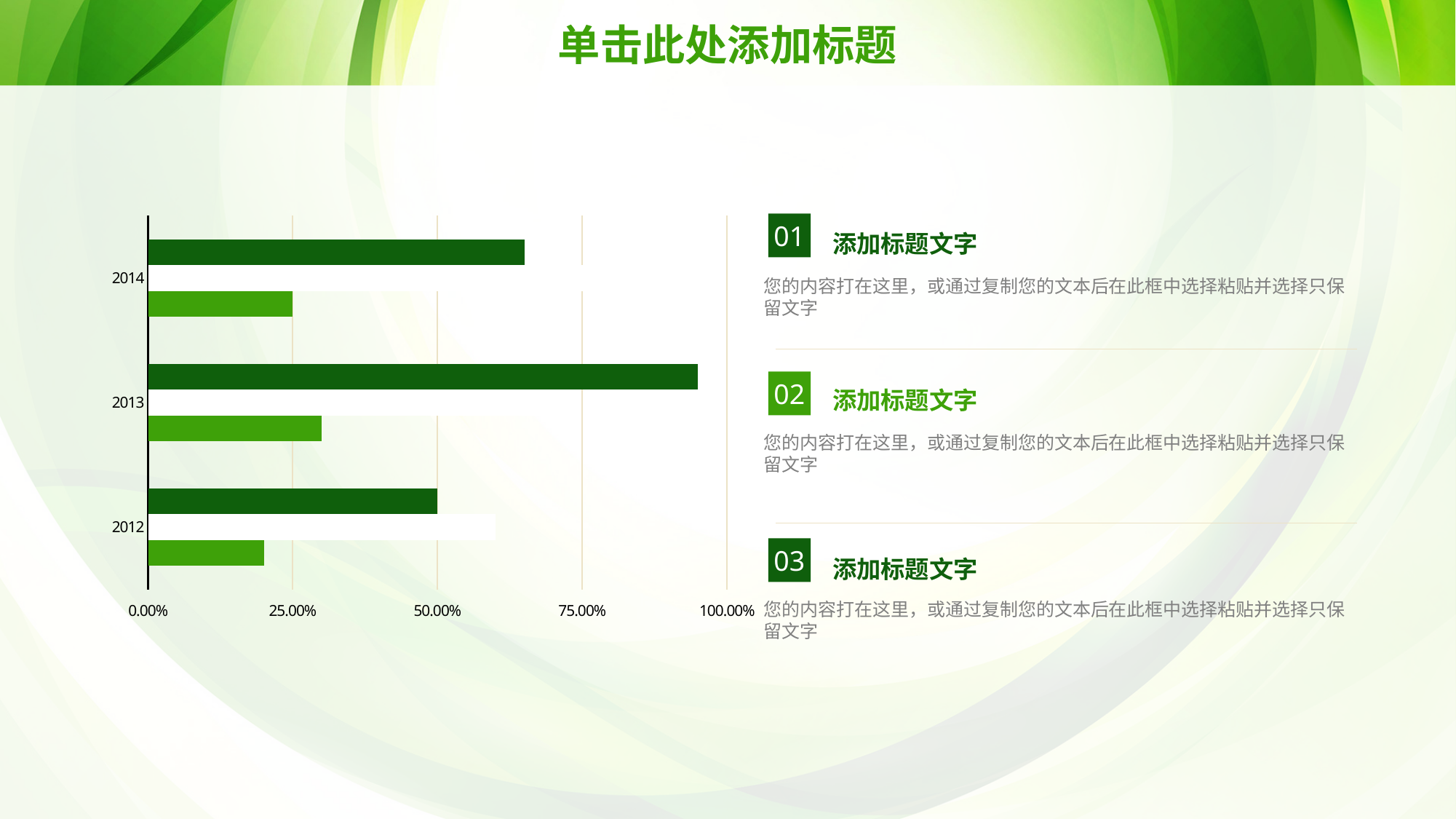
Which year has the shortest light green bar? 2012 What kind of chart is shown on the slide? bar chart Which year has the longest light green bar? 2013 Is the dark green bar for 2013 greater or less than 75.00%? greater How many year categories are shown on the chart's vertical axis? 3 Which year has the shortest dark green bar? 2012 What is the highest value shown on the chart's horizontal axis? 100.00% Is the light green bar for 2012 greater or less than 25.00%? less Is the dark green bar for 2014 greater or less than 50.00%? greater Which year has the longest dark green bar? 2013 Which year is listed at the top of the chart's vertical axis? 2014 Is the dark green bar for 2014 longer or shorter than the dark green bar for 2013? shorter